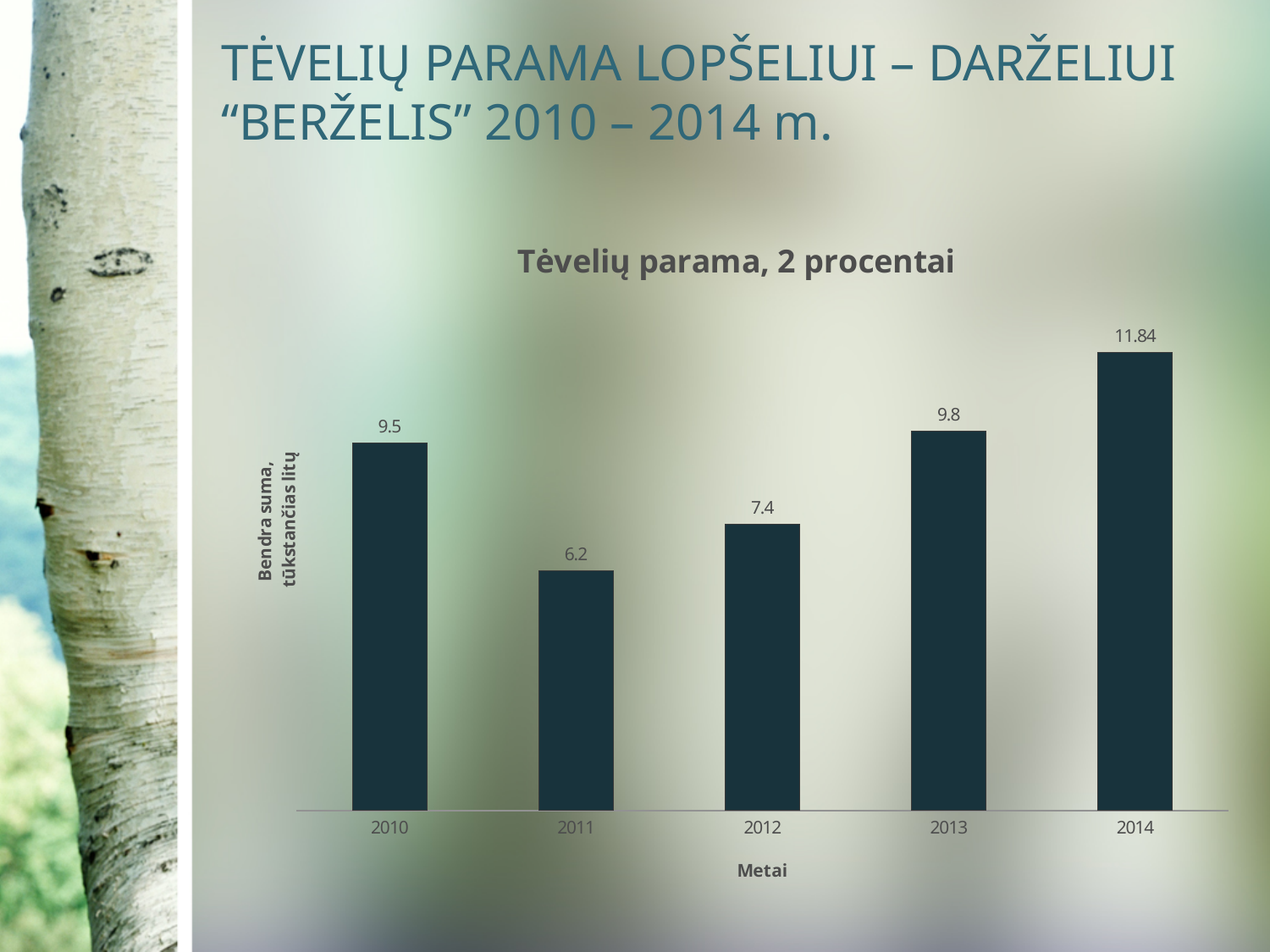
What is the difference between the values for 2010 and 2011? 3.3 What kind of chart is shown? bar chart What is the value for 2012? 7.4 What is the value for 2011? 6.2 How many years are shown on the x axis? 5 What is the title of the chart? Tėvelių parama, 2 procentai Which is larger, the value for 2012 or the value for 2013? 2013 What is the difference between the values for 2014 and 2013? 2.04 What is the value for 2014? 11.84 Which year has the lowest value? 2011 Which year has the highest value? 2014 What is the value for 2010? 9.5